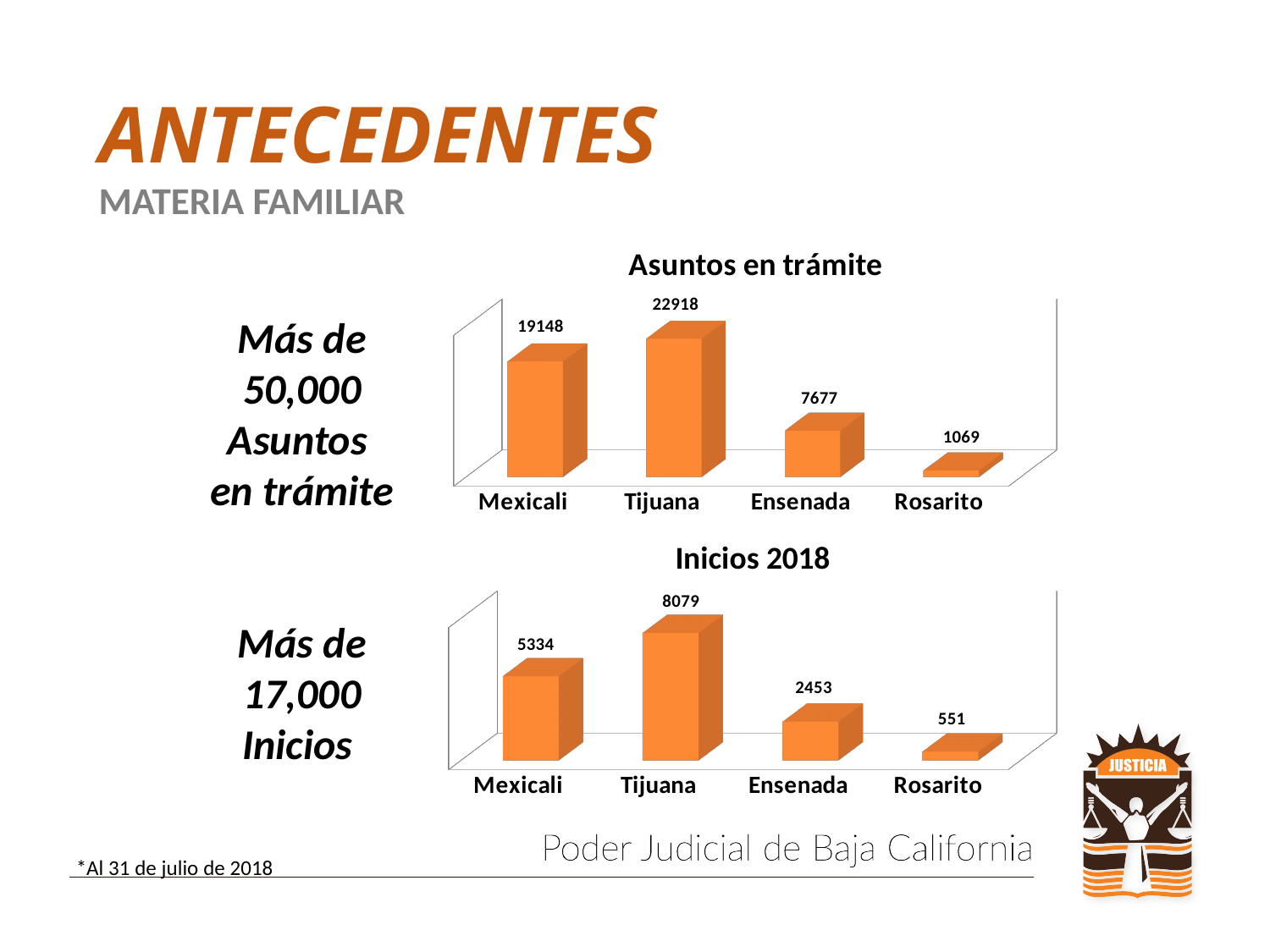
How many categories are shown in the 'Inicios 2018' chart? 4 In the 'Inicios 2018' chart, what is the value for Mexicali? 5334 In the 'Inicios 2018' chart, which is larger, the value for Ensenada or the value for Rosarito? Ensenada In the 'Asuntos en trámite' chart, which category has the lowest value? Rosarito What kind of chart is the 'Asuntos en trámite' chart? Bar chart In the 'Asuntos en trámite' chart, what is the difference between the values for Tijuana and Mexicali? 3770 In the 'Inicios 2018' chart, what is the difference between the values for Tijuana and Ensenada? 5626 In the 'Asuntos en trámite' chart, which category has the highest value? Tijuana In the 'Inicios 2018' chart, what is the value for Ensenada? 2453 In the 'Inicios 2018' chart, which category has the highest value? Tijuana In the 'Asuntos en trámite' chart, what is the value for Tijuana? 22918 In the 'Asuntos en trámite' chart, what is the value for Rosarito? 1069